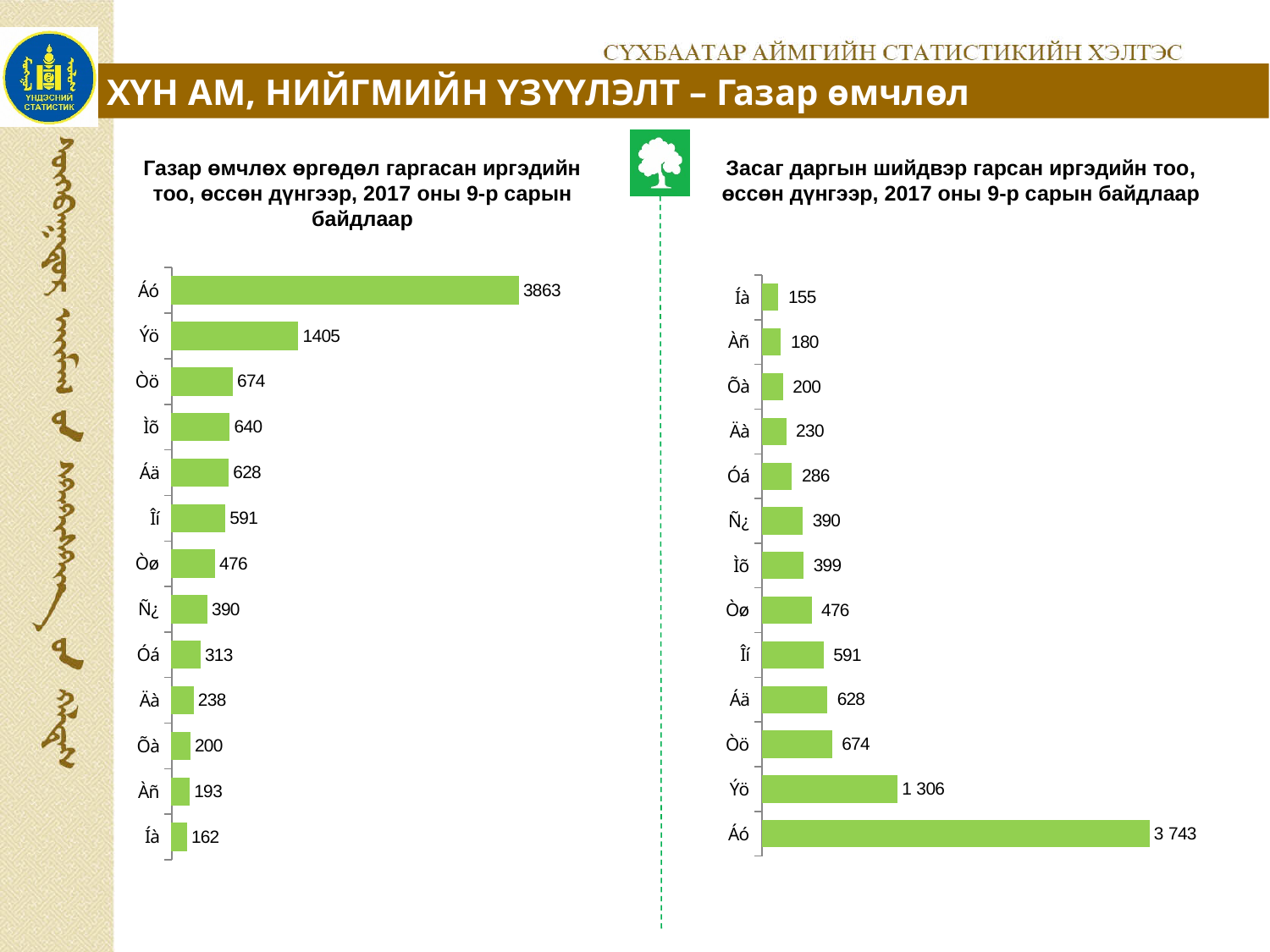
How many categories are shown in the left chart? 13 How many categories are shown in the right chart? 13 In the right chart, which is larger: the value for Óá or the value for Ñ¿? Ñ¿ In the right chart, what is the difference between the values for Òö and Íà? 519 In the left chart, which is larger: the value for Òö or the value for Ìõ? Òö In the left chart, what is the value for Òø? 476 What type of chart is the right chart? Bar chart In the left chart, which category has the lowest value? Íà In the right chart, which category has the highest value? Áó In the left chart, what is the difference between the values for Áó and Ýö? 2458 In the left chart (Газар өмчлөх өргөдөл гаргасан иргэдийн тоо), what is the value for Áó? 3863 In the right chart (Засаг даргын шийдвэр гарсан иргэдийн тоо), what is the value for Ýö? 1 306